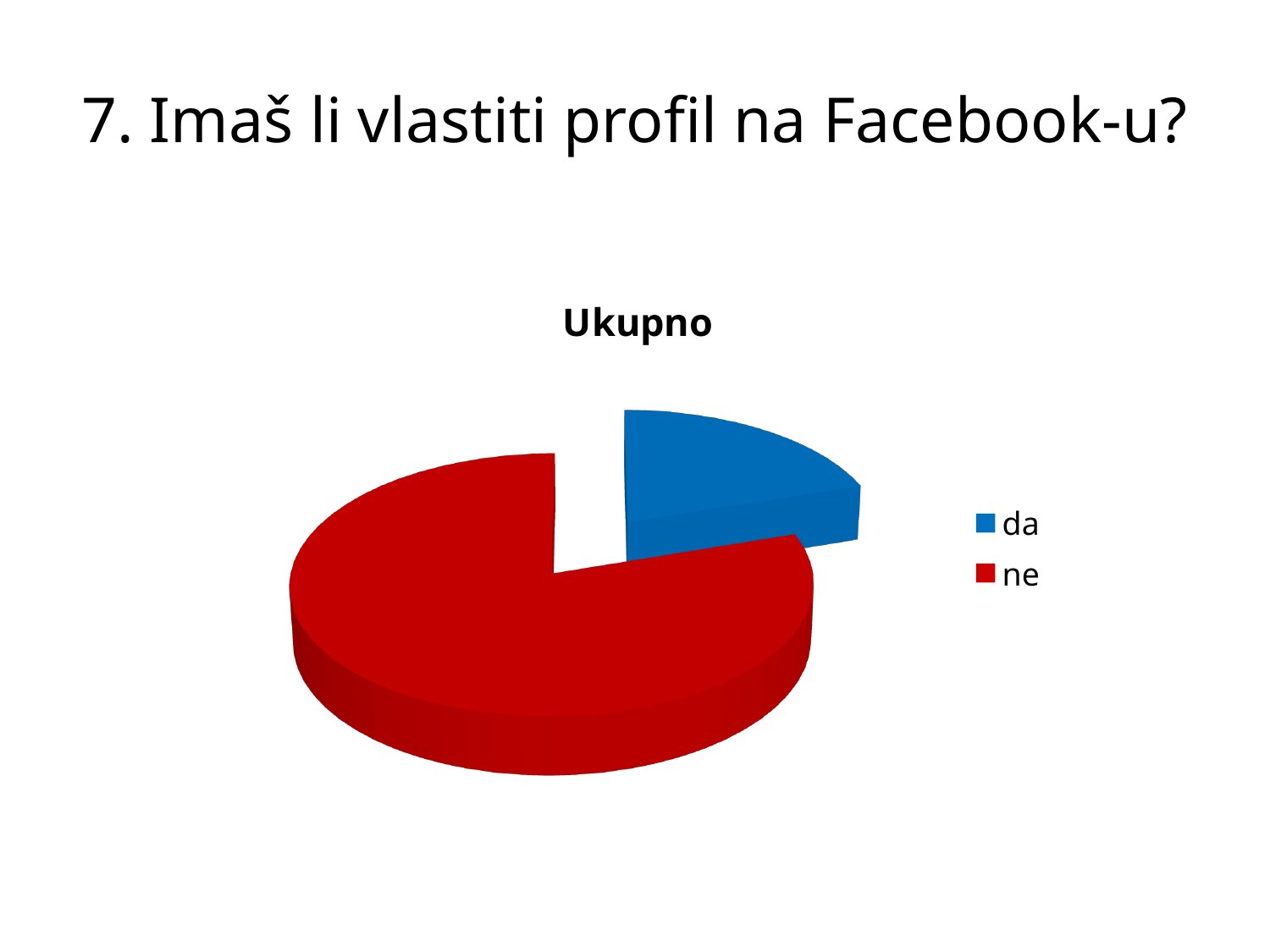
Which category has the smallest slice of the pie? da How many categories does the legend list? 2 Is the share of the "da" slice greater or less than 50%? less What is the title of the chart? Ukupno Which category has the largest slice of the pie? ne Is the share of the "ne" slice greater or less than 50%? greater What colour is the slice for "ne"? red Which slice is larger, "da" or "ne"? ne What kind of chart is shown on the slide? pie chart